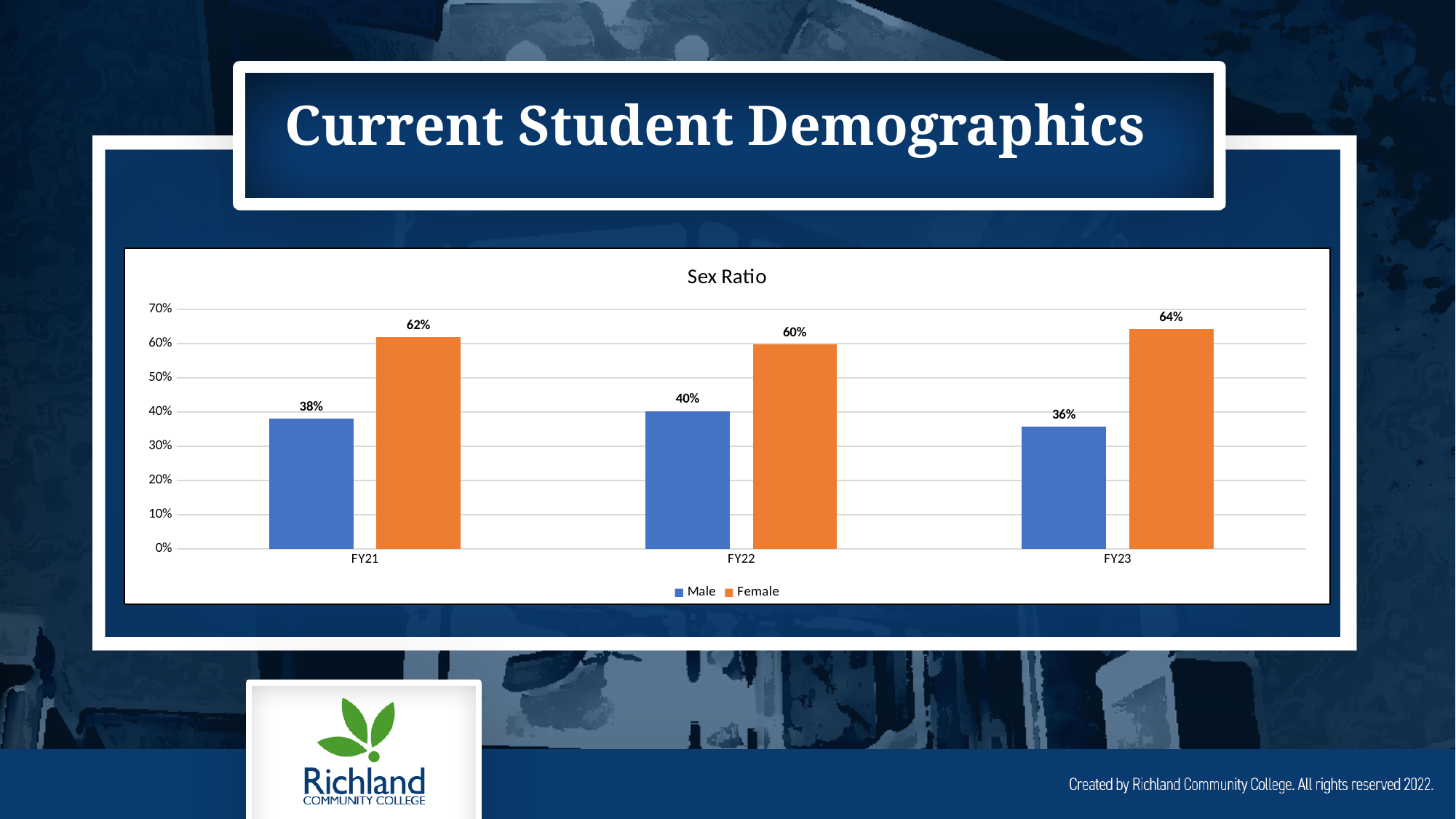
What is the title of the chart? Sex Ratio What is the Female value for FY22? 60% What is the Male value for FY21? 38% What is the Female value for FY23? 64% What is the difference between the Female and Male values in FY21? 24% Which is larger in FY22, the Male value or the Female value? Female How many fiscal years are shown on the x axis? 3 What kind of chart is shown? bar chart How many series does the legend list? 2 Is the Male value for FY22 greater or less than 50%? less In which fiscal year is the Female share highest? FY23 In which fiscal year is the Male share lowest? FY23